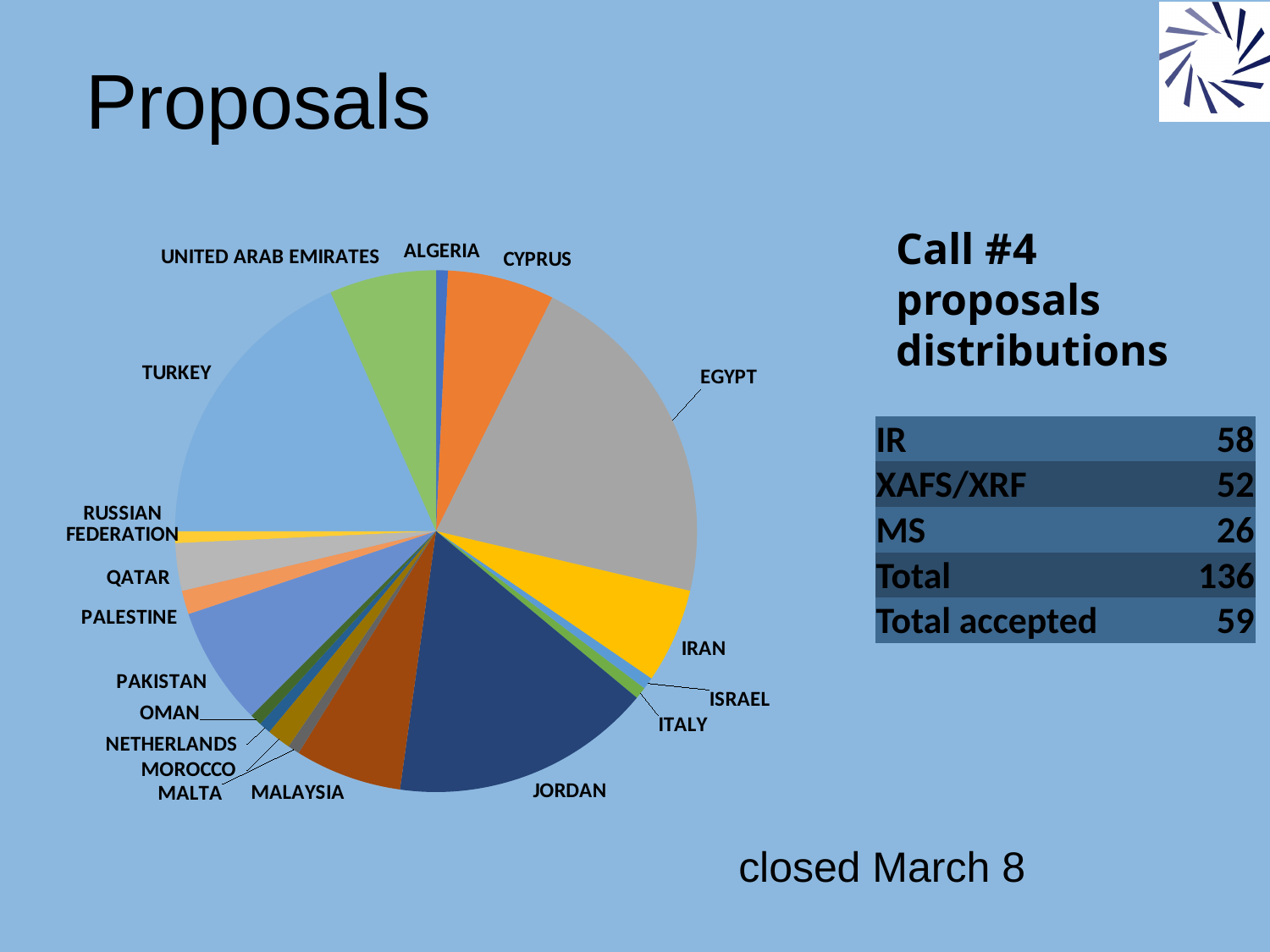
What colour is the Egypt slice in the pie chart? gray Which country has the largest slice in the pie chart? Egypt Which slice is larger in the pie chart, Jordan or Iran? Jordan Which slice is larger in the pie chart, Pakistan or Qatar? Pakistan Which slice is larger in the pie chart, Cyprus or Israel? Cyprus What kind of chart is shown on the slide? pie chart What title is given next to the pie chart describing what it shows? Call #4 proposals distributions How many countries are labelled as slices in the pie chart? 18